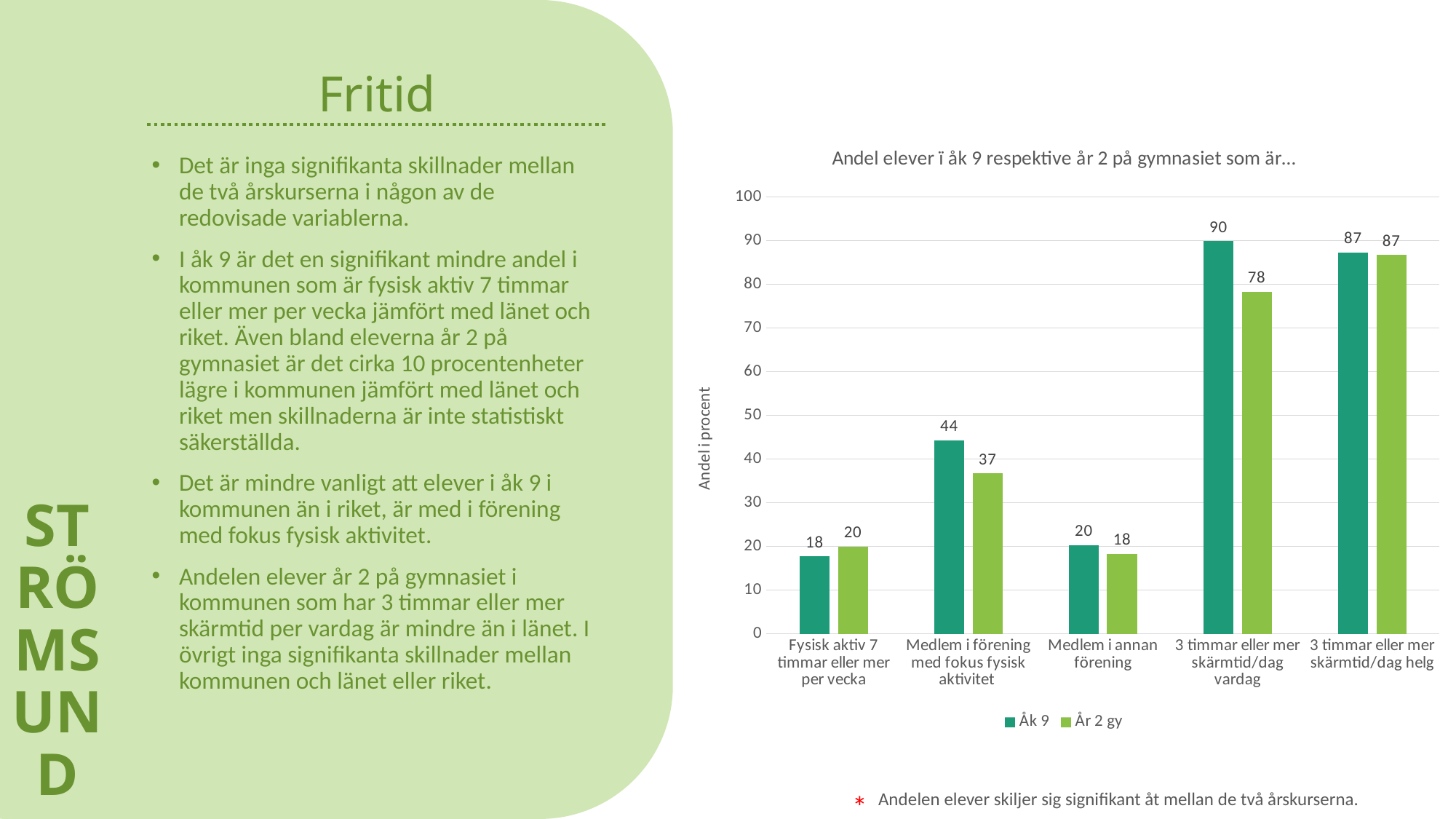
Which category has the highest value for Åk 9? 3 timmar eller mer skärmtid/dag vardag Which category has the lowest value for År 2 gy? Medlem i annan förening What kind of chart is shown on the slide? Bar chart How many series does the legend list? 2 How many categories are shown on the x axis? 5 Which series has the larger value in the category 'Medlem i förening med fokus fysisk aktivitet', Åk 9 or År 2 gy? Åk 9 What is the value for År 2 gy in the category 'Fysisk aktiv 7 timmar eller mer per vecka'? 20 What is the difference between Åk 9 and År 2 gy in the category '3 timmar eller mer skärmtid/dag vardag'? 12 What are the two series listed in the legend? Åk 9 and År 2 gy What is the value for År 2 gy in the category '3 timmar eller mer skärmtid/dag vardag'? 78 What is the value for Åk 9 in the category 'Medlem i förening med fokus fysisk aktivitet'? 44 What is the label of the y axis? Andel i procent